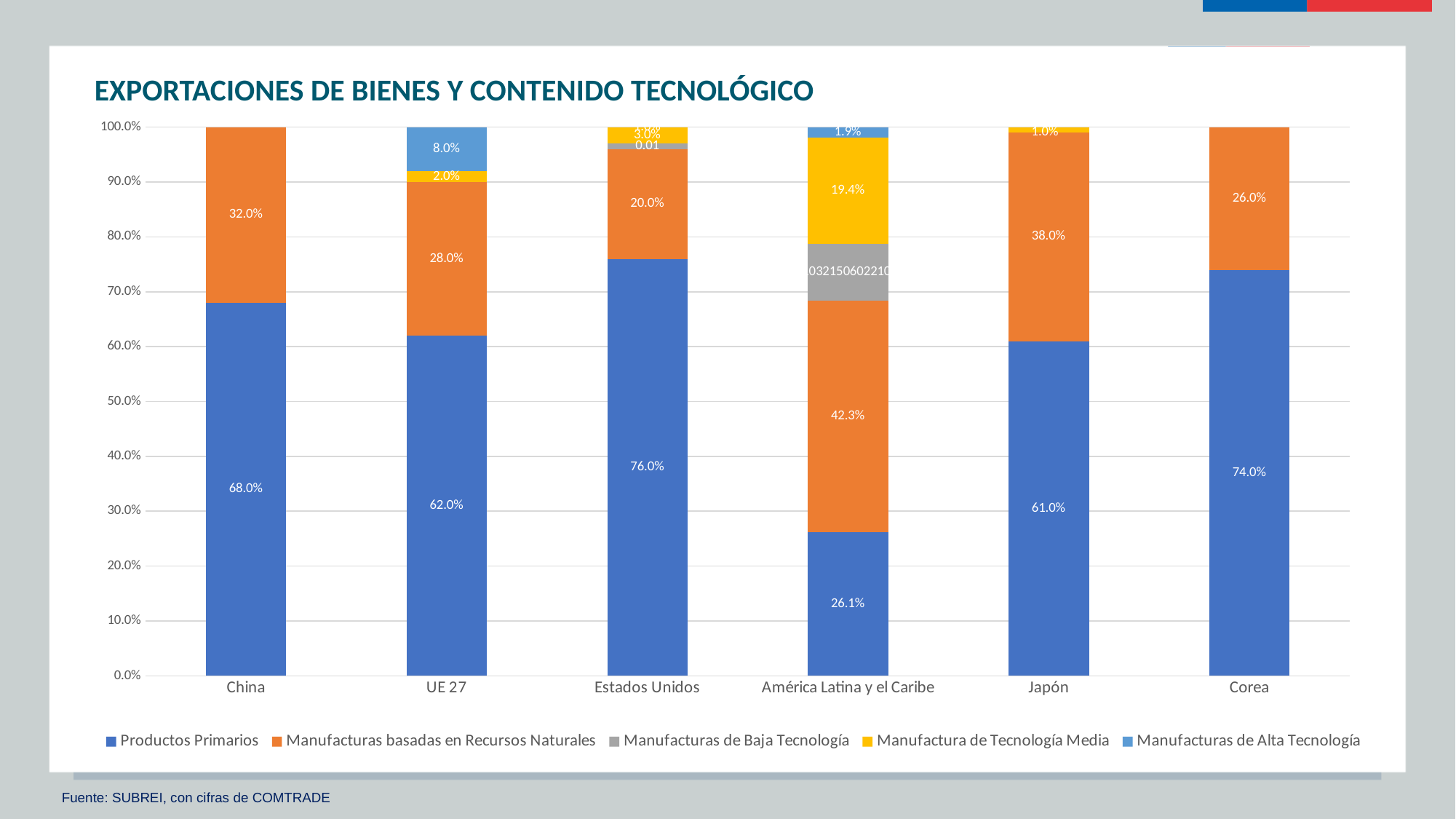
What is the value of Manufactura de Tecnología Media for América Latina y el Caribe? 19.4% Which category has the highest value for Productos Primarios? Estados Unidos Which is larger, the Manufacturas basadas en Recursos Naturales value for China or for Corea? China What is the title of the chart? EXPORTACIONES DE BIENES Y CONTENIDO TECNOLÓGICO How many series does the legend list? 5 What is the value of Manufacturas de Alta Tecnología for UE 27? 8.0% What is the difference between the Productos Primarios values for Corea and China? 6.0% What kind of chart is shown on the slide? Stacked bar chart Which category has the lowest value for Productos Primarios? América Latina y el Caribe What is the value of Manufacturas basadas en Recursos Naturales for Japón? 38.0% How many categories are shown on the x axis? 6 What is the value of Productos Primarios for Estados Unidos? 76.0%